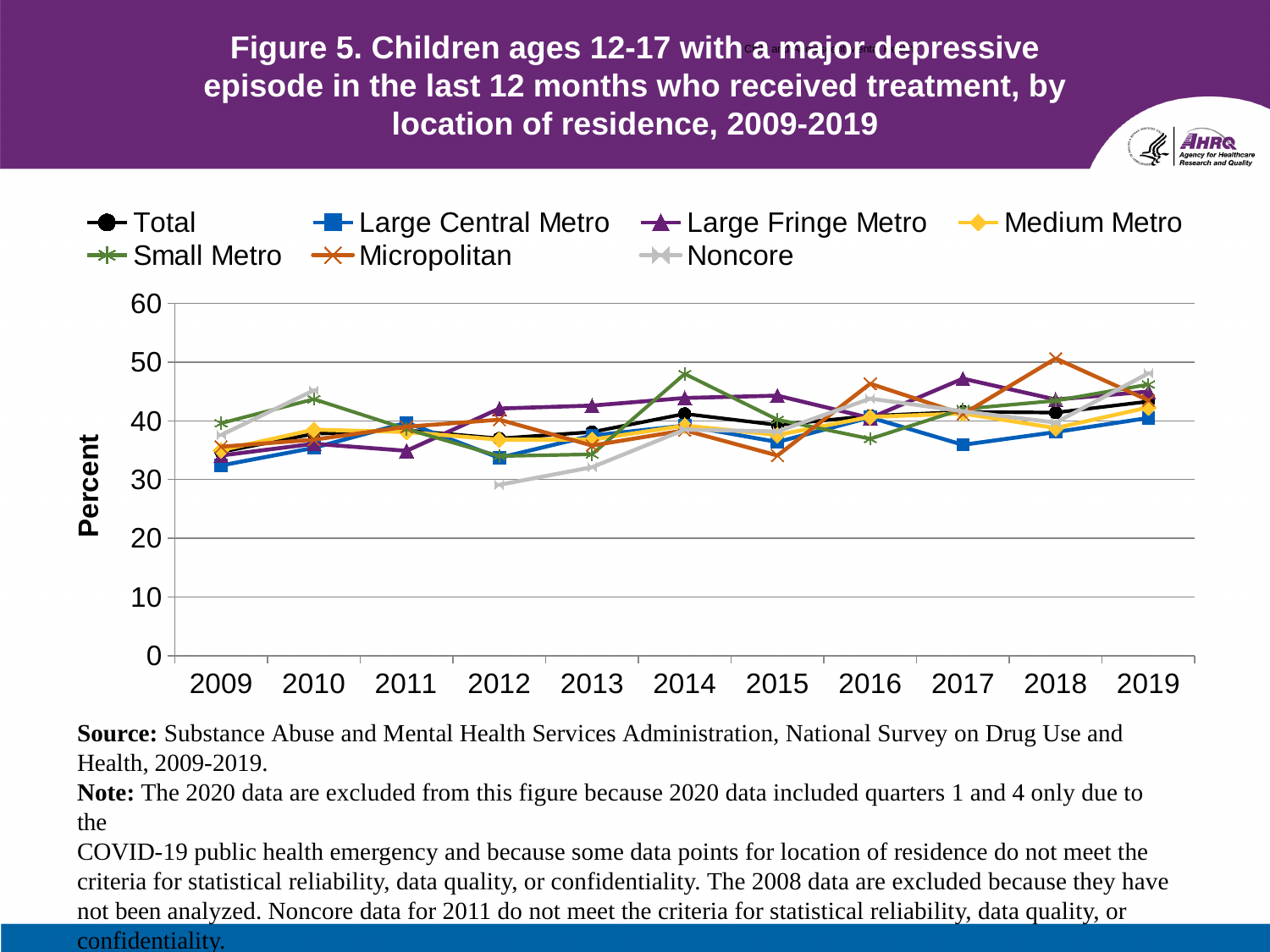
What is the label of the vertical axis? Percent Is the value for Micropolitan in 2015 greater or less than 40? less How many series does the legend list? 7 Which series has the lowest value in 2012? Noncore What kind of chart is shown on the slide? Line chart Is the value for Small Metro in 2014 greater or less than 40? greater Which series has the highest value in 2014? Small Metro Which series has the highest value in 2018? Micropolitan In 2014, which is larger: the value for Small Metro or the value for Large Central Metro? Small Metro How many years are shown along the x axis? 11 Is the value for Large Central Metro in 2009 greater or less than 40? less Does the Total series rise or fall overall from 2009 to 2019? Rise